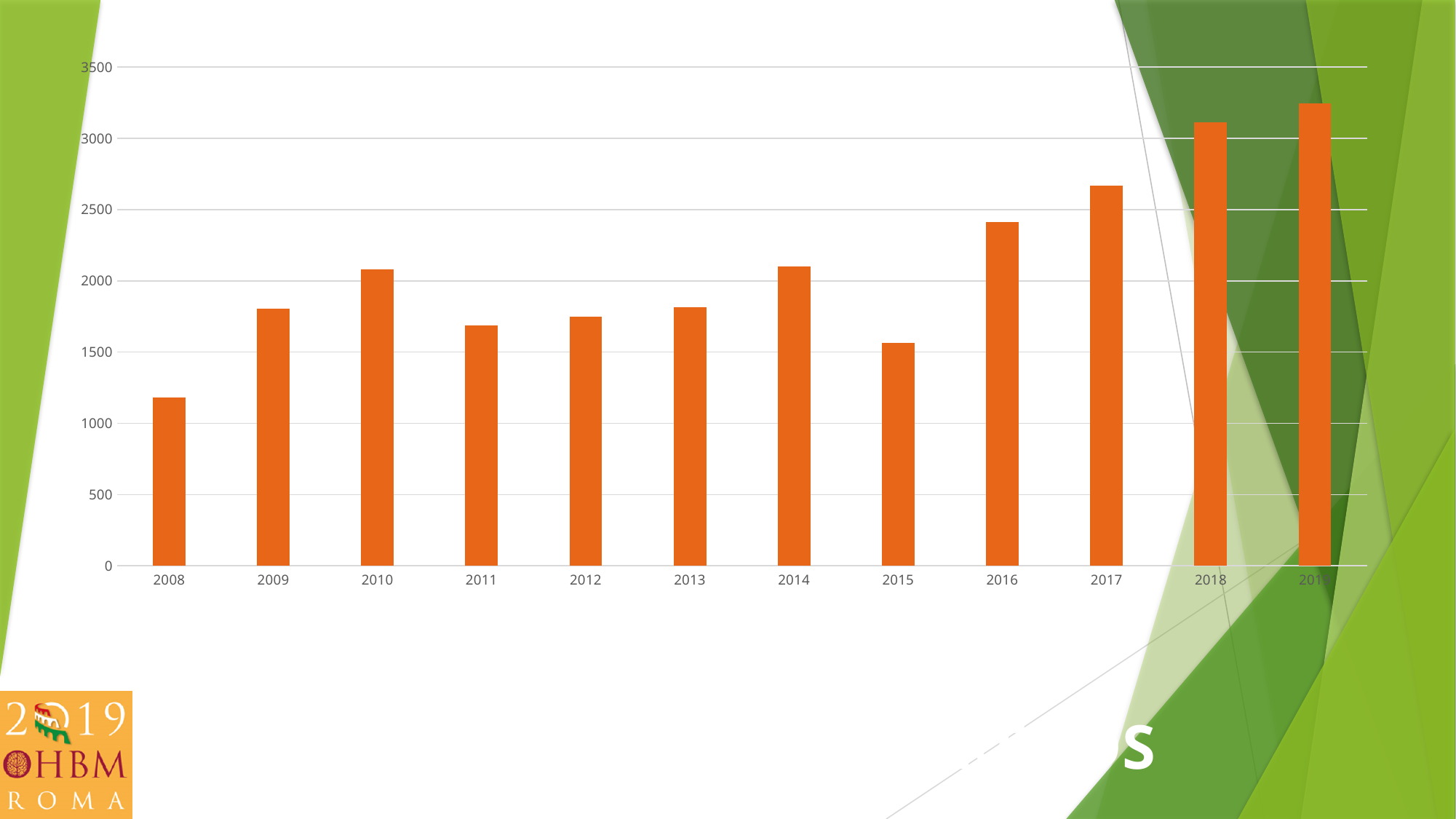
What colour are the bars in the chart? orange Which year has the larger value, 2014 or 2015? 2014 Is the value for 2017 greater or less than 2500? greater How many years are shown on the x axis of the chart? 12 What kind of chart is shown on the slide? bar chart Which year has the lowest bar in the chart? 2008 Is the value for 2018 greater or less than 3000? greater From 2015 to 2019, do the values rise or fall? rise Which year has the larger value, 2016 or 2017? 2017 Is the value for 2015 greater or less than 2000? less Which year has the highest bar in the chart? 2019